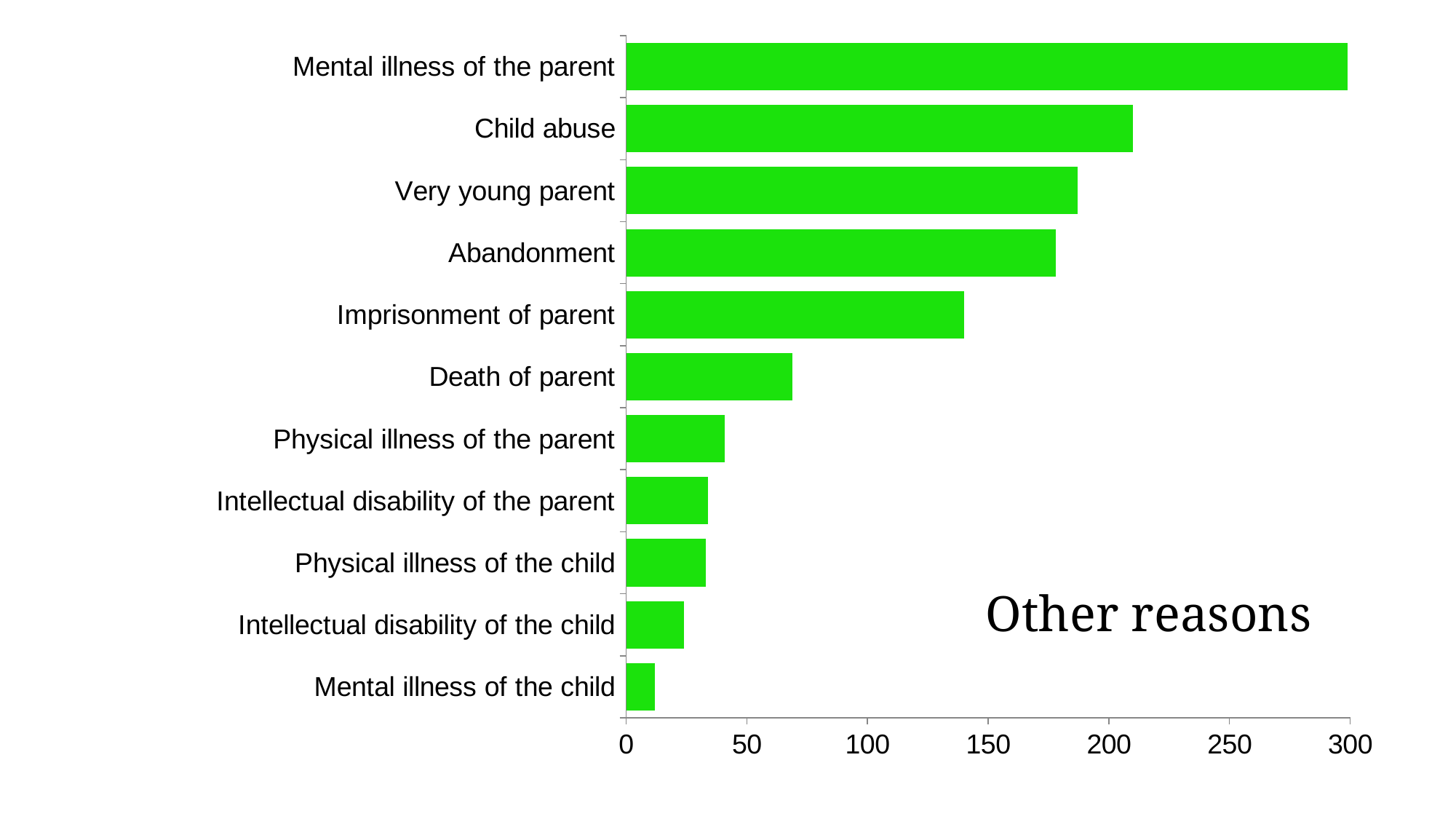
Is the value for Child abuse greater or less than 200? greater Which reason has the highest value? Mental illness of the parent Is the value for Very young parent greater or less than 200? less How many categories (reasons) are plotted in the chart? 11 Is the value for Abandonment greater or less than 150? greater Which reason has the lowest value? Mental illness of the child What kind of chart is shown on the slide? Bar chart Which is larger, the value for Death of parent or the value for Physical illness of the parent? Death of parent What is the title of the chart? Other reasons Which is larger, the value for Child abuse or the value for Very young parent? Child abuse